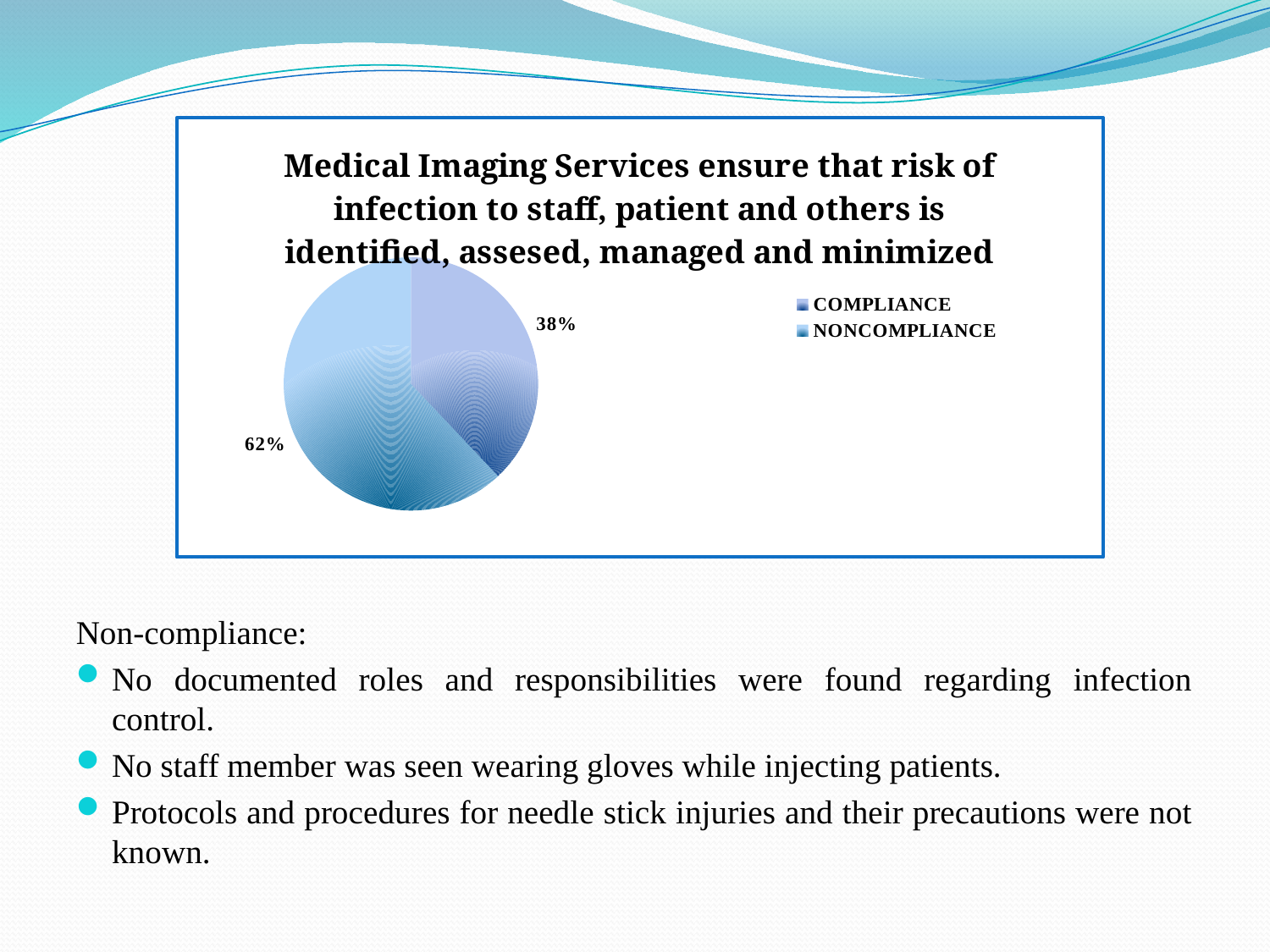
Which category has the smallest slice of the pie? COMPLIANCE Which legend entry is listed first? COMPLIANCE Which slice is larger, COMPLIANCE or NONCOMPLIANCE? NONCOMPLIANCE What kind of chart is shown on the slide? pie chart What is the title of the chart? Medical Imaging Services ensure that risk of infection to staff, patient and others is identified, assesed, managed and minimized How many slices does the pie chart have? 2 What share of the pie is labelled NONCOMPLIANCE? 62% What is the difference in percentage points between the NONCOMPLIANCE and COMPLIANCE slices? 24 What share of the pie is labelled COMPLIANCE? 38% Which category has the largest slice of the pie? NONCOMPLIANCE How many entries does the legend list? 2